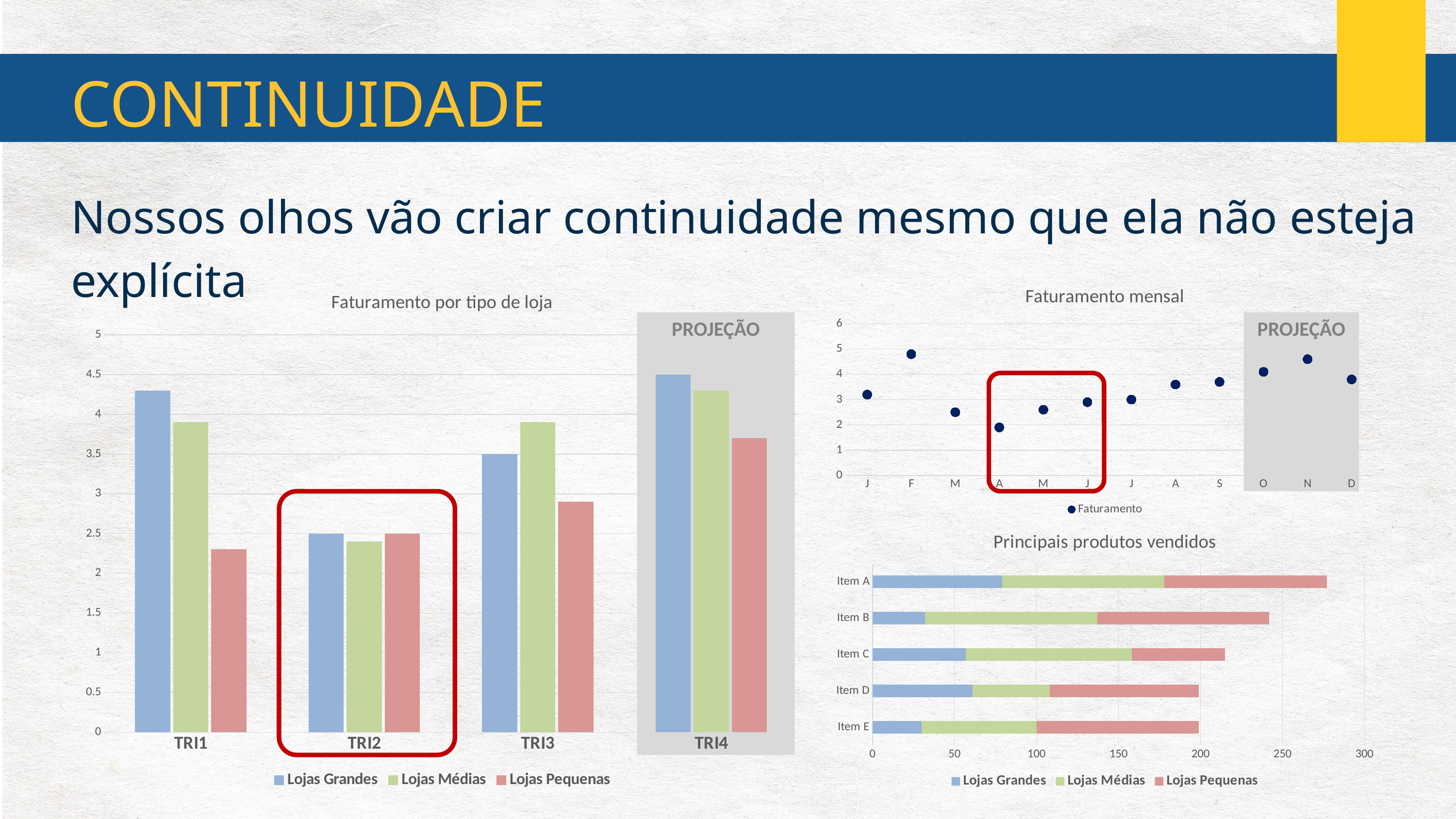
In "Faturamento por tipo de loja", how many series does the legend list? 3 In "Principais produtos vendidos", which item has the longest total bar? Item A In "Faturamento por tipo de loja", which is larger in TRI3: Lojas Médias or Lojas Pequenas? Lojas Médias In "Faturamento por tipo de loja", is the value for Lojas Grandes in TRI1 greater or less than 4? greater In "Faturamento mensal", is the value for F greater or less than 4? greater In "Faturamento por tipo de loja", how many quarter categories are shown on the x axis? 4 In "Principais produtos vendidos", is the total for Item A greater or less than 250? greater What kind of chart is "Faturamento por tipo de loja"? bar chart In "Faturamento mensal", which month has the lowest value? A (April) In "Faturamento mensal", how many data points are plotted? 12 In "Faturamento por tipo de loja", which quarter is marked as PROJEÇÃO? TRI4 In "Faturamento por tipo de loja", which quarter has the lowest value for Lojas Grandes? TRI2